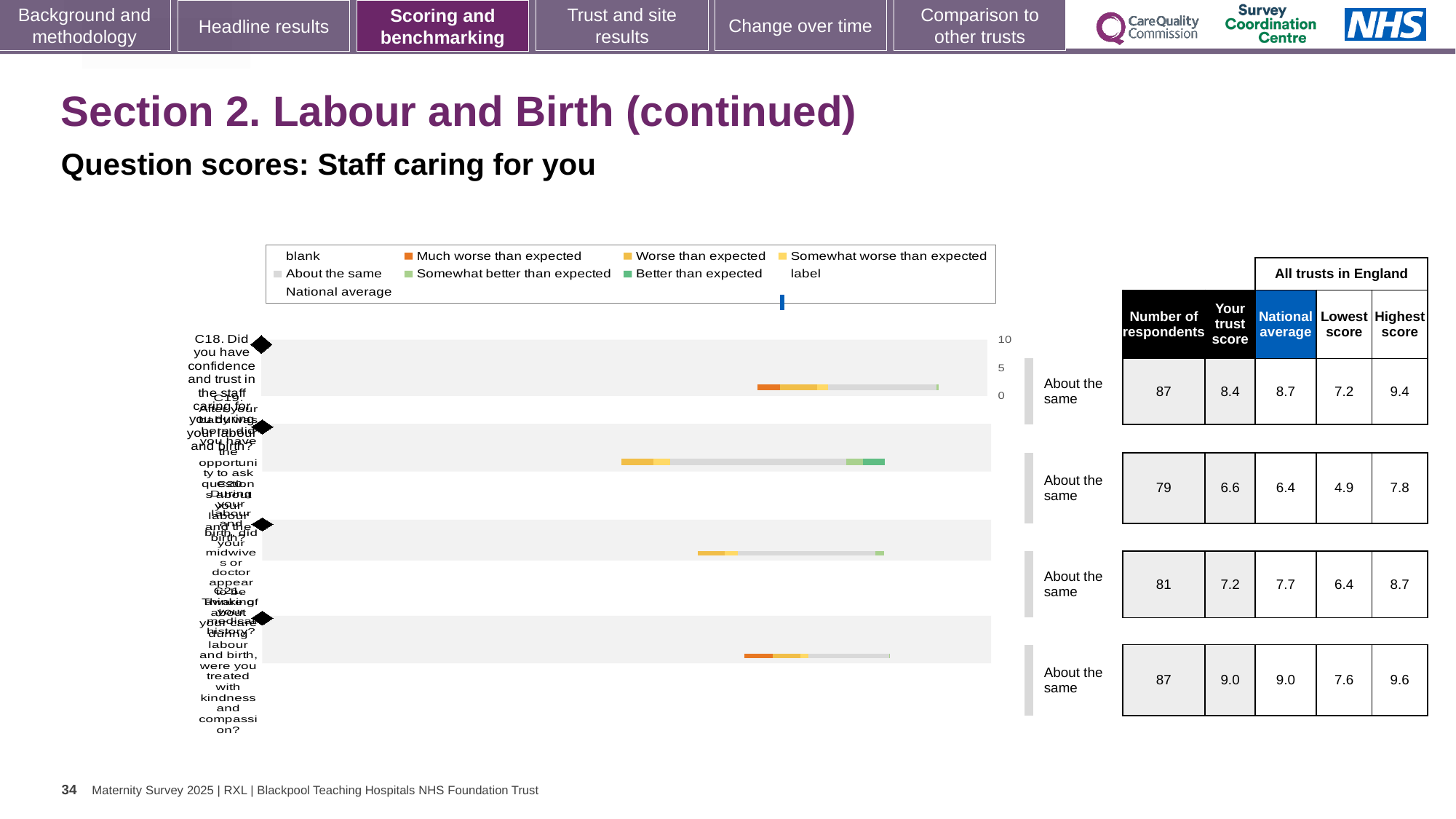
What benchmark category is shown next to each of the four rows in the chart? About the same What kind of chart is shown on the slide? bar chart In the table, what is 'Your trust score' for the first row (C18)? 8.4 For the first row (C18), what is the difference between the national average and your trust score? 0.3 In the table, what is the national average for the first row (C18)? 8.7 In the table, what is the number of respondents for the first row (C18, confidence and trust in the staff caring for you)? 87 In the table, what is the highest score among all trusts in England for the fourth row (C21)? 9.6 How many survey questions (rows) are plotted in the chart? 4 Which row has the lowest 'Your trust score' in the table? the second row, 6.6 For the second row, which is larger: your trust score or the national average? your trust score (6.6) Which row has the highest 'Your trust score' in the table? the fourth row (C21), 9.0 In the table, what is the lowest score among all trusts in England for the second row? 4.9